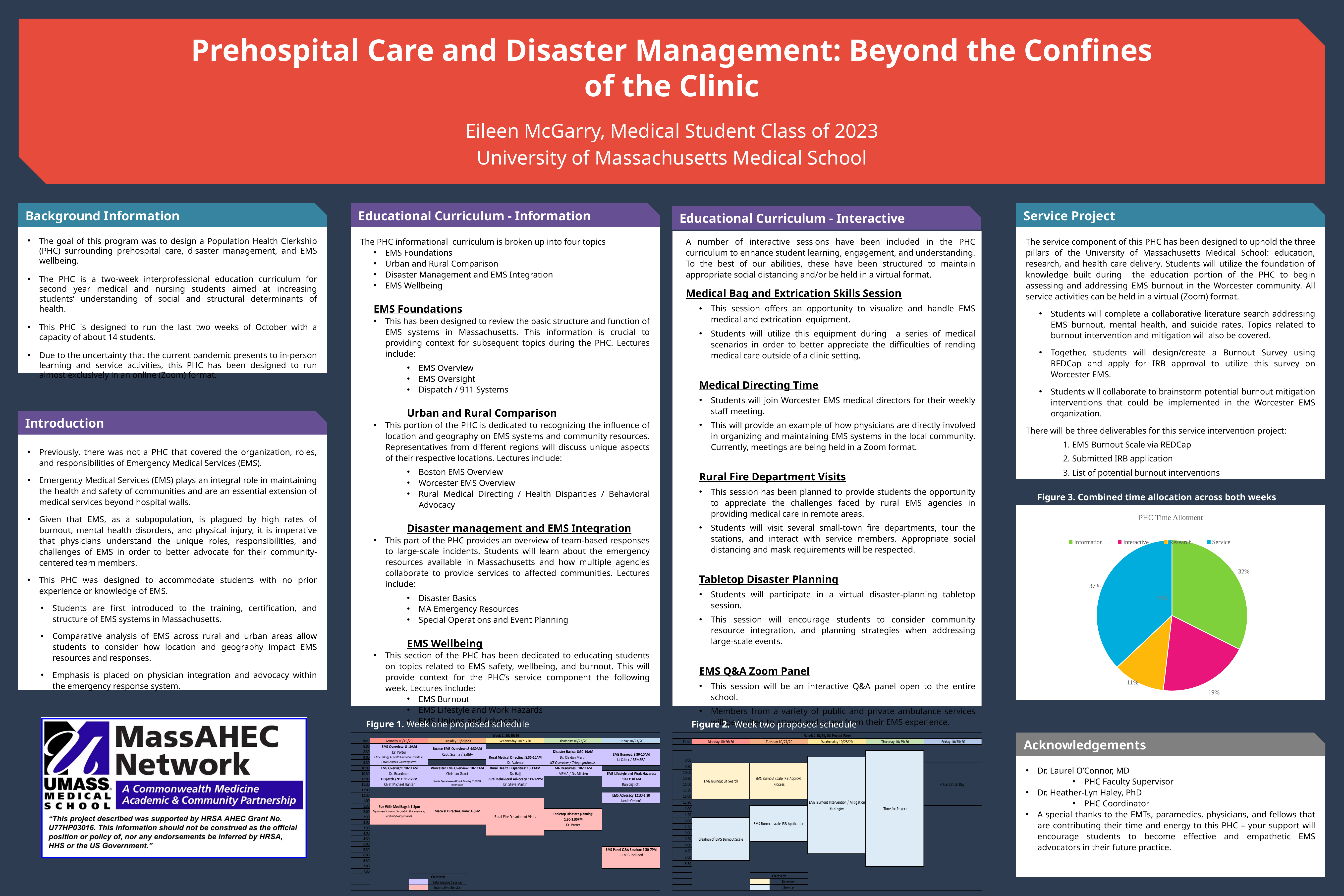
What is the title printed on the pie chart in Figure 3? PHC Time Allotment In the PHC Time Allotment pie chart, how many percentage points larger is the Service share than the Information share? 5% In the PHC Time Allotment pie chart, what share of time is allotted to Research? 11% In the PHC Time Allotment pie chart, what share of time is allotted to Information? 32% In the PHC Time Allotment pie chart, what share of time is allotted to Interactive? 19% In the PHC Time Allotment pie chart, what share of time is allotted to Service? 37% How many slices does the PHC Time Allotment pie chart have? 4 Which category has the largest slice in the PHC Time Allotment pie chart? Service Which category has the smallest slice in the PHC Time Allotment pie chart? Research What colour represents Information in the PHC Time Allotment pie chart? Green In the PHC Time Allotment pie chart, which is larger: the Interactive share or the Research share? Interactive What kind of chart is shown in Figure 3? Pie chart